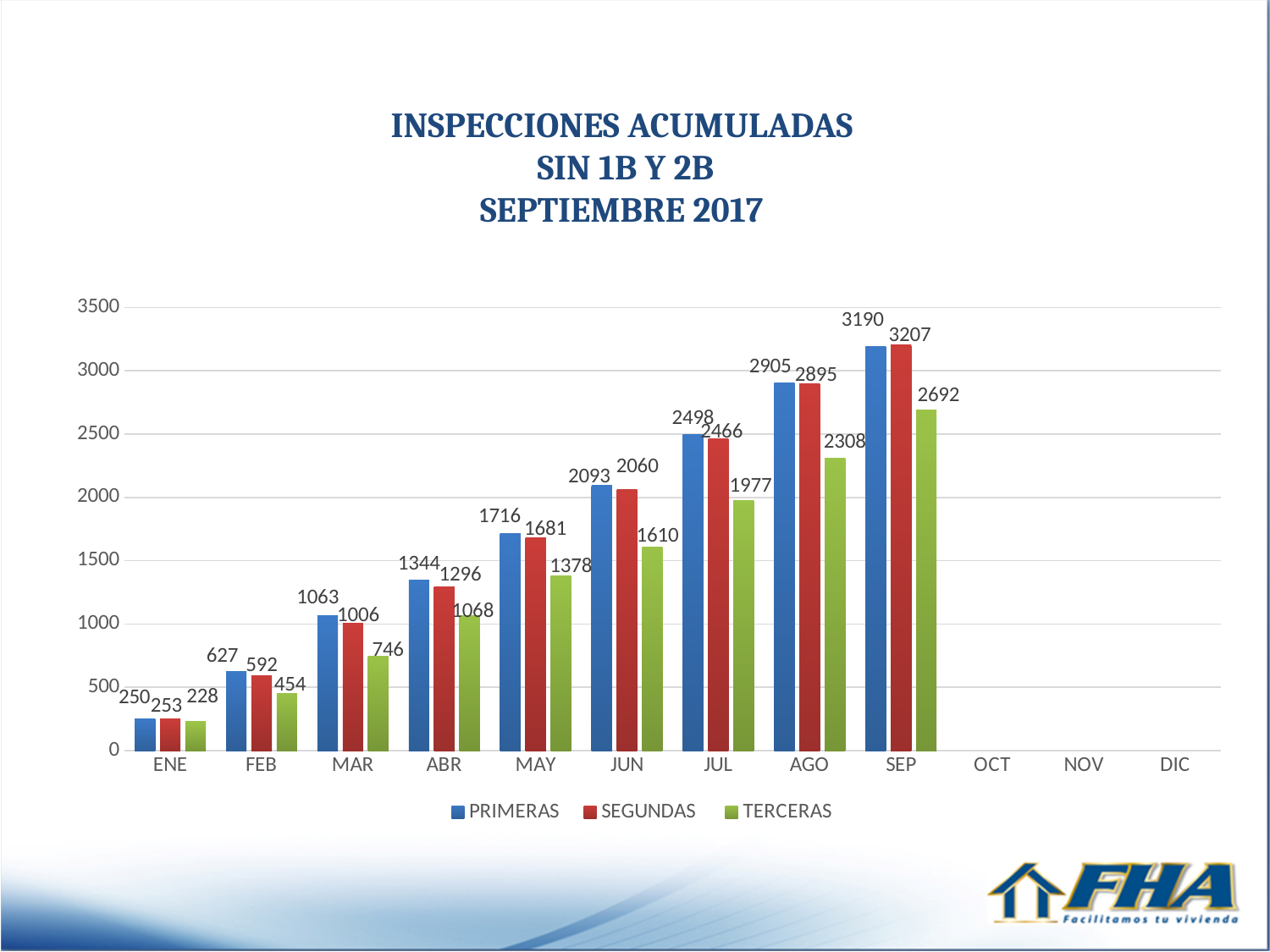
What is the value for PRIMERAS in SEP? 3190 What kind of chart is shown? bar chart Which month has the lowest value for PRIMERAS? ENE Do the PRIMERAS values rise or fall from ENE to SEP? rise How many months have data plotted? 9 What is the value for SEGUNDAS in MAR? 1006 What is the value for TERCERAS in JUL? 1977 How many series does the legend list? 3 Which month has the highest value for TERCERAS? SEP Which is larger in SEP, PRIMERAS or SEGUNDAS? SEGUNDAS What is the difference between PRIMERAS and TERCERAS in AGO? 597 Is the value for SEGUNDAS in JUN greater or less than 2000? greater